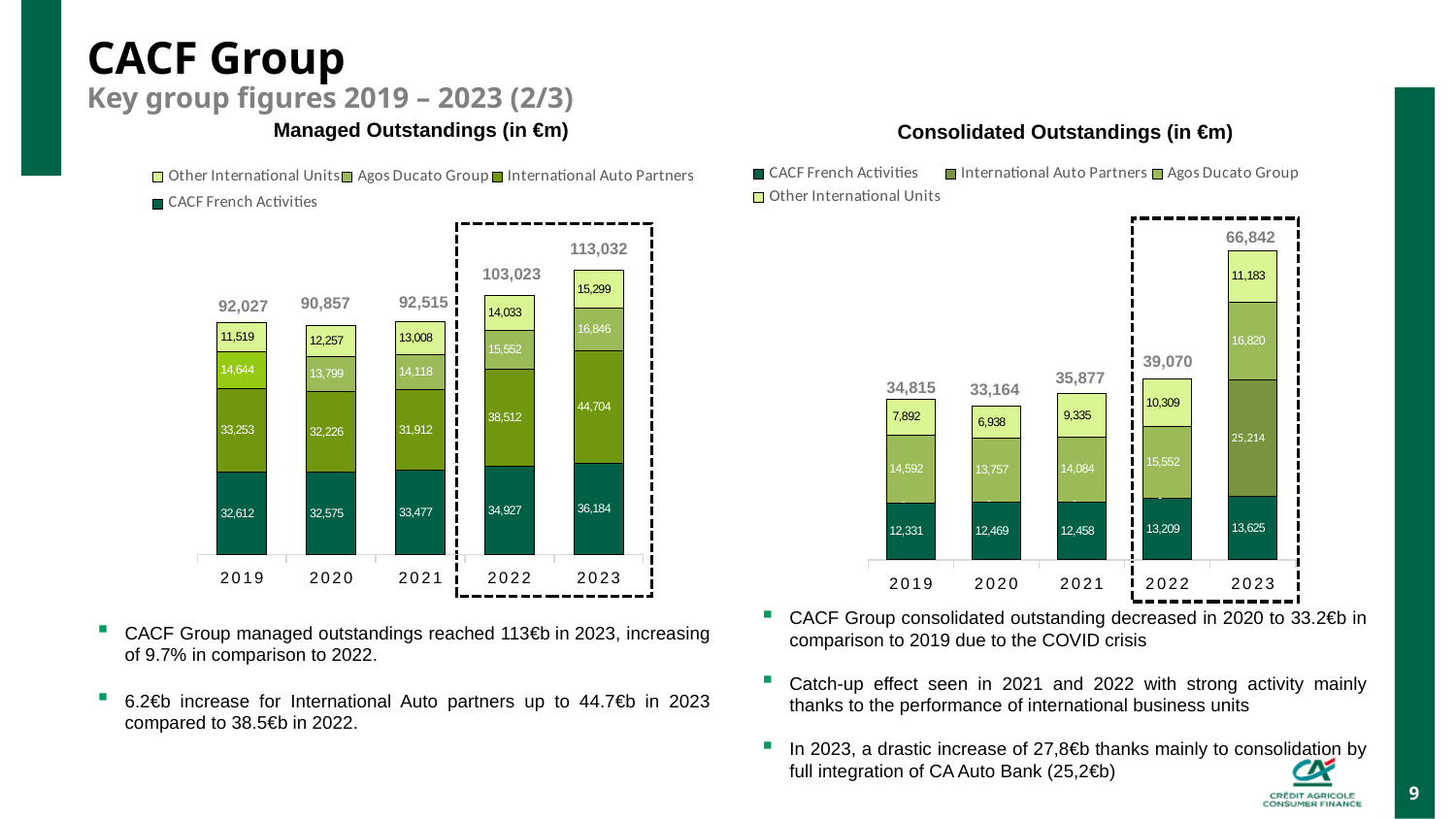
How many years are shown on the x axis of the Managed Outstandings chart? 5 In the Managed Outstandings chart, what is the difference between the 2023 total and the 2022 total? 10,009 In the Consolidated Outstandings chart, what is the total shown for 2023? 66,842 In the Managed Outstandings chart, which year has the lowest total? 2020 In the Consolidated Outstandings chart, what is the value for CACF French Activities in 2022? 13,209 How many series does the legend of the Consolidated Outstandings chart list? 4 In the Consolidated Outstandings chart, which year has the highest total? 2023 In the Managed Outstandings chart, what is the value for CACF French Activities in 2019? 32,612 In the Managed Outstandings chart, what is the value for International Auto Partners in 2023? 44,704 In the Consolidated Outstandings chart, what is the value for International Auto Partners in 2023? 25,214 In the Managed Outstandings chart, what is the total managed outstandings value shown for 2023? 113,032 In the Consolidated Outstandings chart, which total is larger, 2019 or 2020? 2019